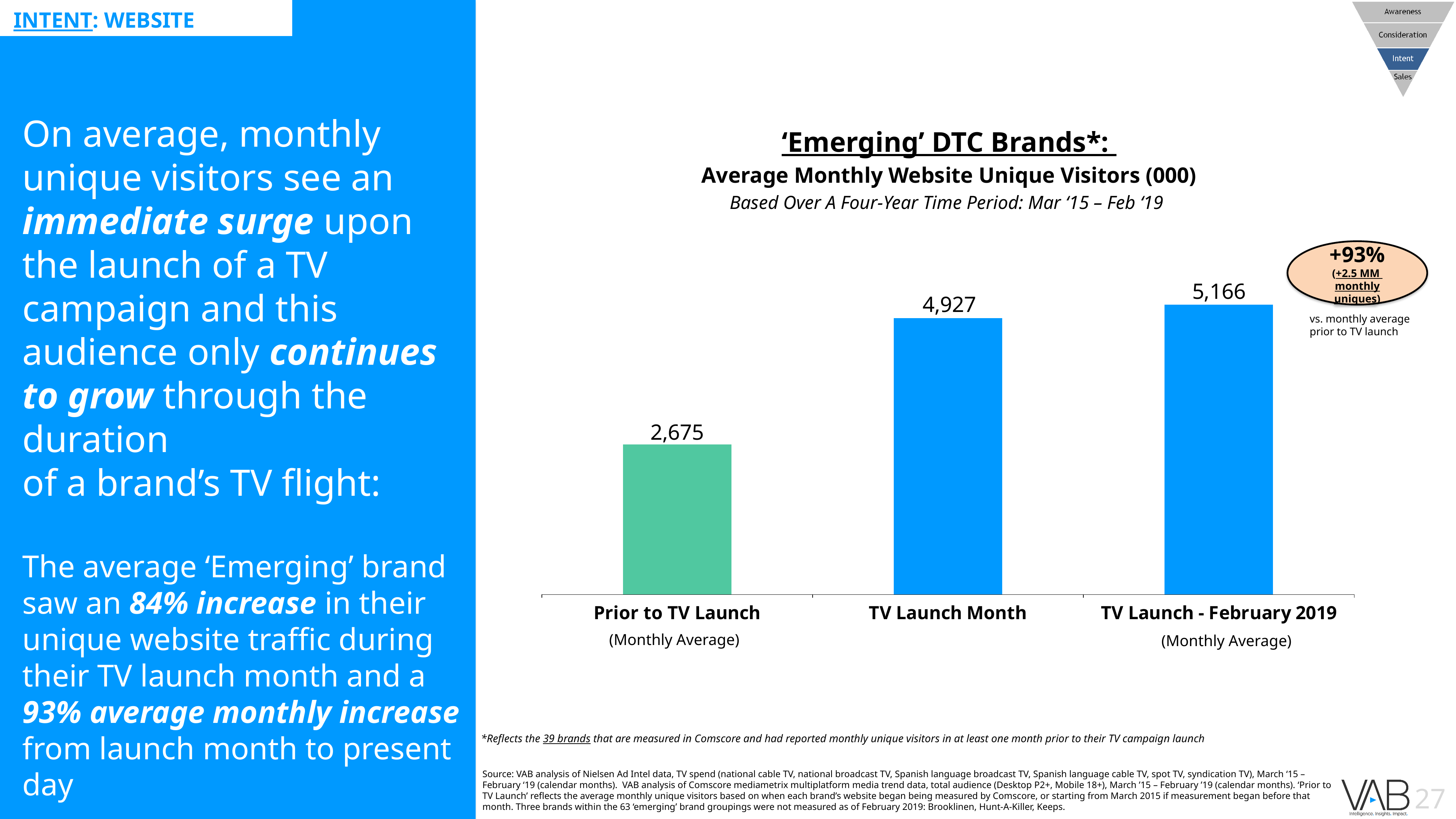
What is the value for TV Launch Month? 4,927 Which category has the lowest value? Prior to TV Launch What kind of chart is shown on the slide? Bar chart What is the value for Prior to TV Launch? 2,675 Do the values rise or fall from left to right across the categories? Rise How many categories are shown on the chart? 3 What percentage increase is shown in the callout next to the TV Launch - February 2019 bar? +93% What is the difference between the TV Launch Month value and the Prior to TV Launch value? 2,252 Which is larger, the value for TV Launch Month or the value for Prior to TV Launch? TV Launch Month What is the value for TV Launch - February 2019? 5,166 Which category has the highest value? TV Launch - February 2019 What is the difference between the TV Launch - February 2019 value and the TV Launch Month value? 239